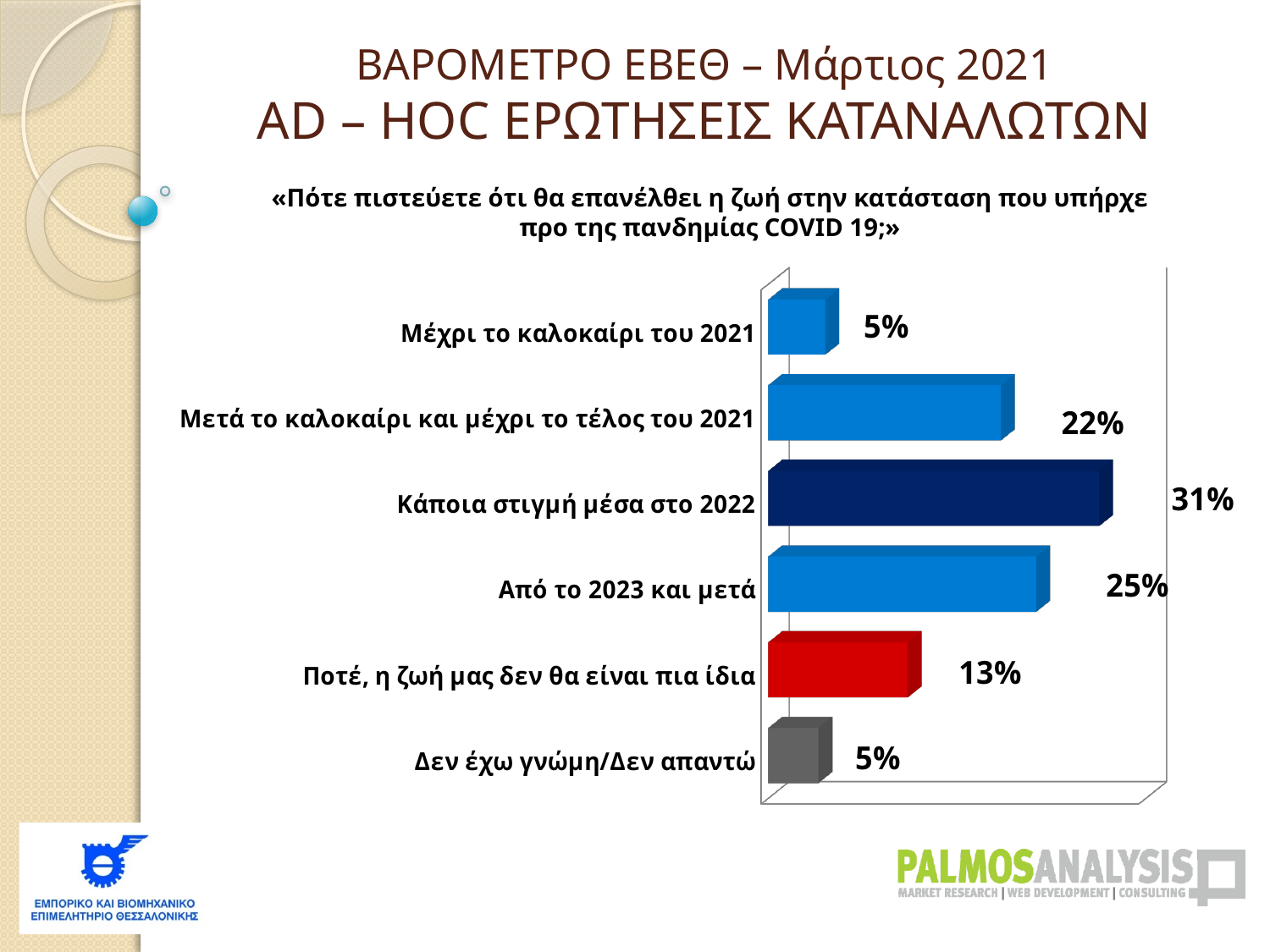
What is the value for "Κάποια στιγμή μέσα στο 2022"? 31% What is the difference between the values for "Μετά το καλοκαίρι και μέχρι το τέλος του 2021" and "Ποτέ, η ζωή μας δεν θα είναι πια ίδια"? 9% Which is larger, the value for "Από το 2023 και μετά" or the value for "Μετά το καλοκαίρι και μέχρι το τέλος του 2021"? Από το 2023 και μετά What kind of chart is shown on the slide? Bar chart How many categories are shown in the chart? 6 What is the value for "Μετά το καλοκαίρι και μέχρι το τέλος του 2021"? 22% What is the value for "Μέχρι το καλοκαίρι του 2021"? 5% What is the value for "Ποτέ, η ζωή μας δεν θα είναι πια ίδια"? 13% What is the value for "Από το 2023 και μετά"? 25% What colour is the bar for "Ποτέ, η ζωή μας δεν θα είναι πια ίδια"? Red Which category has the highest value? Κάποια στιγμή μέσα στο 2022 What is the difference between the values for "Κάποια στιγμή μέσα στο 2022" and "Από το 2023 και μετά"? 6%